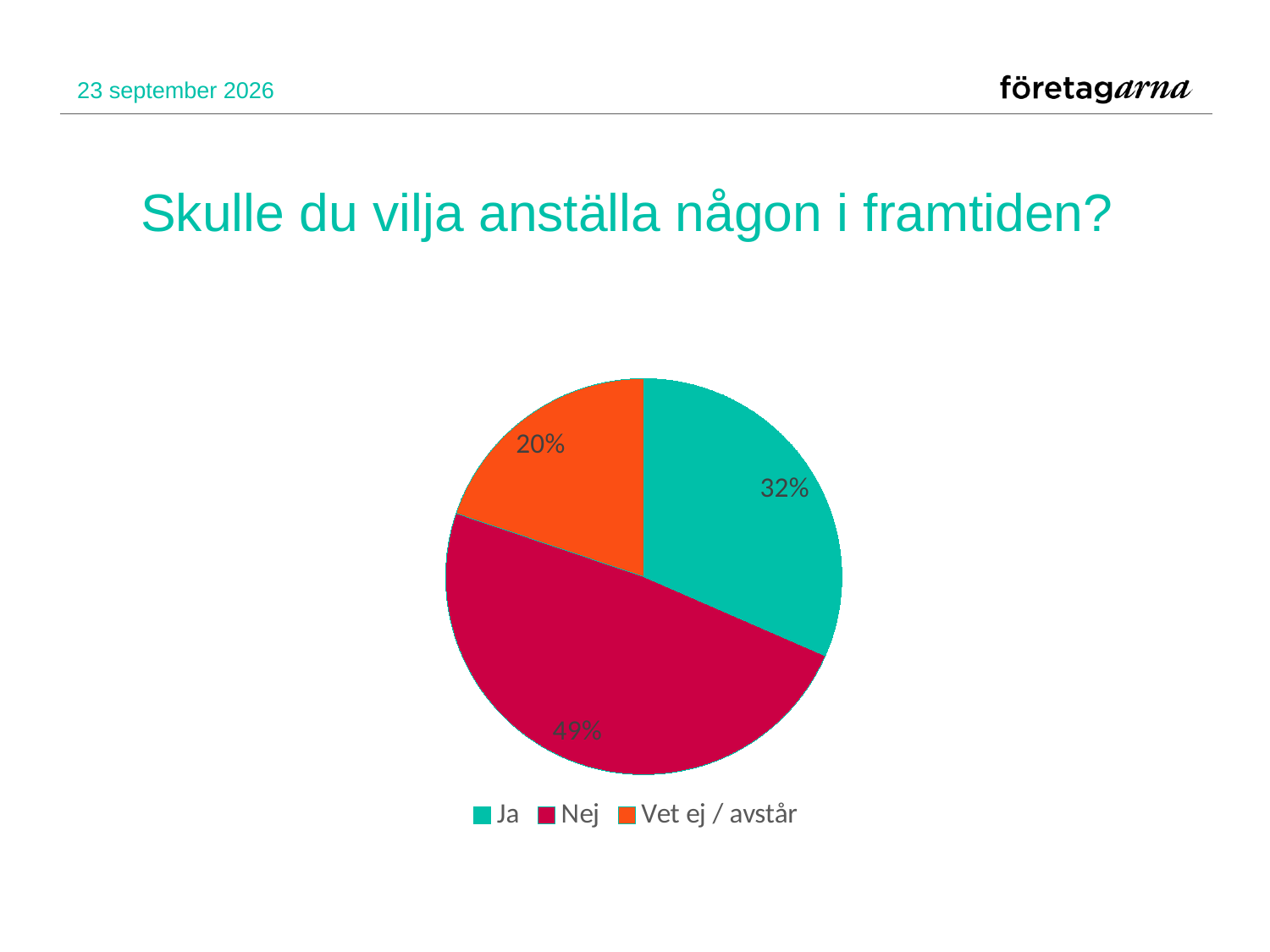
What colour is the "Nej" slice? red What is the difference in percentage points between the "Nej" and "Ja" slices? 17 What share of the pie is labelled "Ja"? 32% Which category has the smallest slice of the pie? Vet ej / avstår What kind of chart is shown on the slide? pie chart How many categories does the legend list? 3 Which category has the largest slice of the pie? Nej What share of the pie is labelled "Vet ej / avstår"? 20% What share of the pie is labelled "Nej"? 49% What is the title of the chart? Skulle du vilja anställa någon i framtiden? Which is larger, the "Ja" slice or the "Vet ej / avstår" slice? Ja What is the difference in percentage points between the "Ja" and "Vet ej / avstår" slices? 12